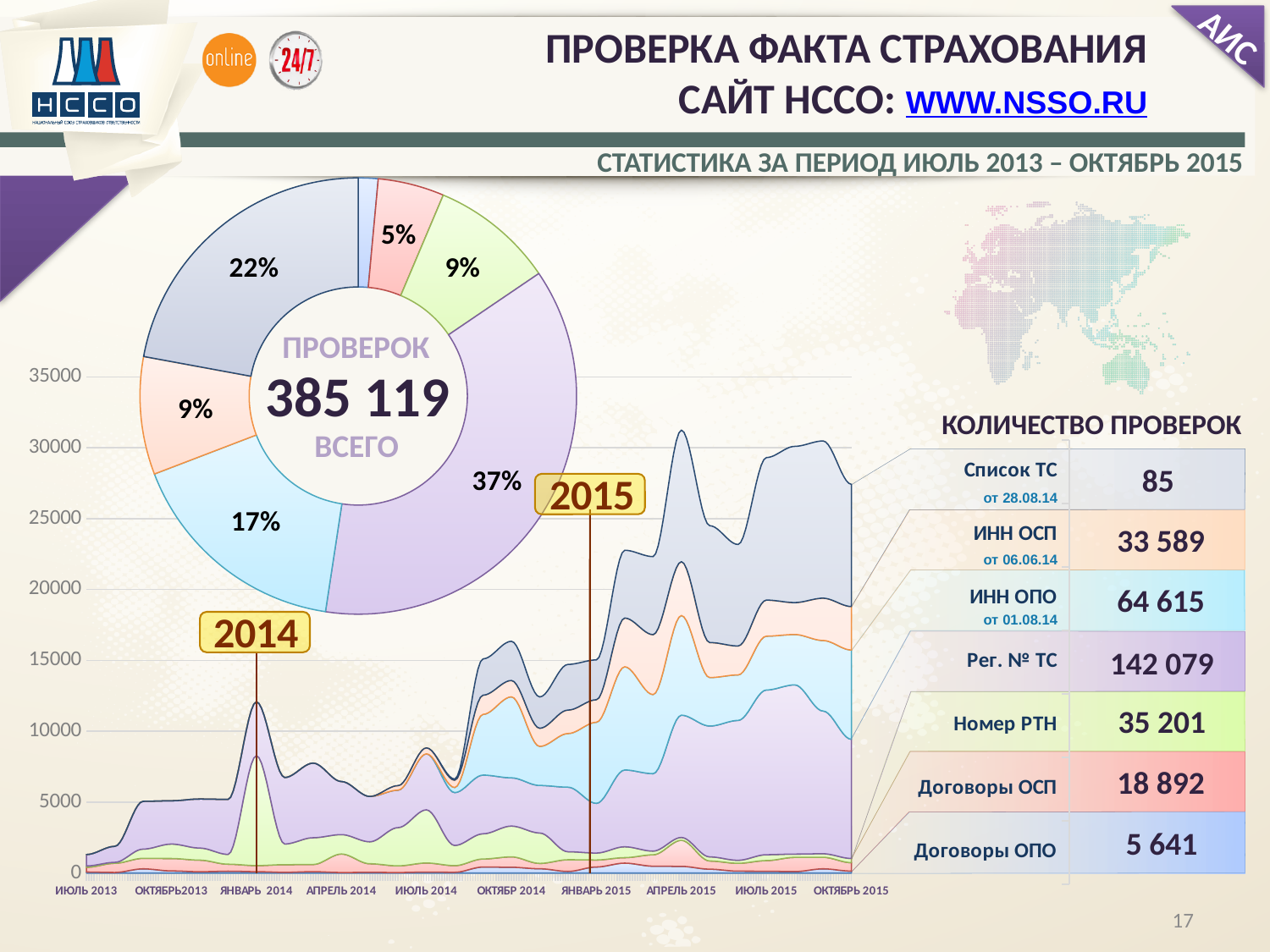
In the area chart, do the total values generally rise or fall from July 2013 to October 2015? rise What is the smallest labelled percentage on the donut chart? 5% In the 'КОЛИЧЕСТВО ПРОВЕРОК' table, how many checks are listed for 'Договоры ОПО'? 5 641 In the 'КОЛИЧЕСТВО ПРОВЕРОК' table, which has more checks: 'ИНН ОСП' or 'ИНН ОПО'? ИНН ОПО What is the largest percentage shown on the donut chart? 37% What total number of checks is shown in the centre of the donut chart? 385 119 In the area chart, is the total value at the January 2014 peak greater or less than 10000? greater What kind of chart is the large chart at the bottom of the slide showing values over time from July 2013 to October 2015? stacked area chart What percentage is shown on the light blue slice of the donut chart? 17% What percentage is shown on the grey-blue slice of the donut chart? 22% In the 'КОЛИЧЕСТВО ПРОВЕРОК' table, how many checks are listed for 'Рег. № ТС'? 142 079 By how many percentage points does the 37% slice exceed the 22% slice on the donut chart? 15